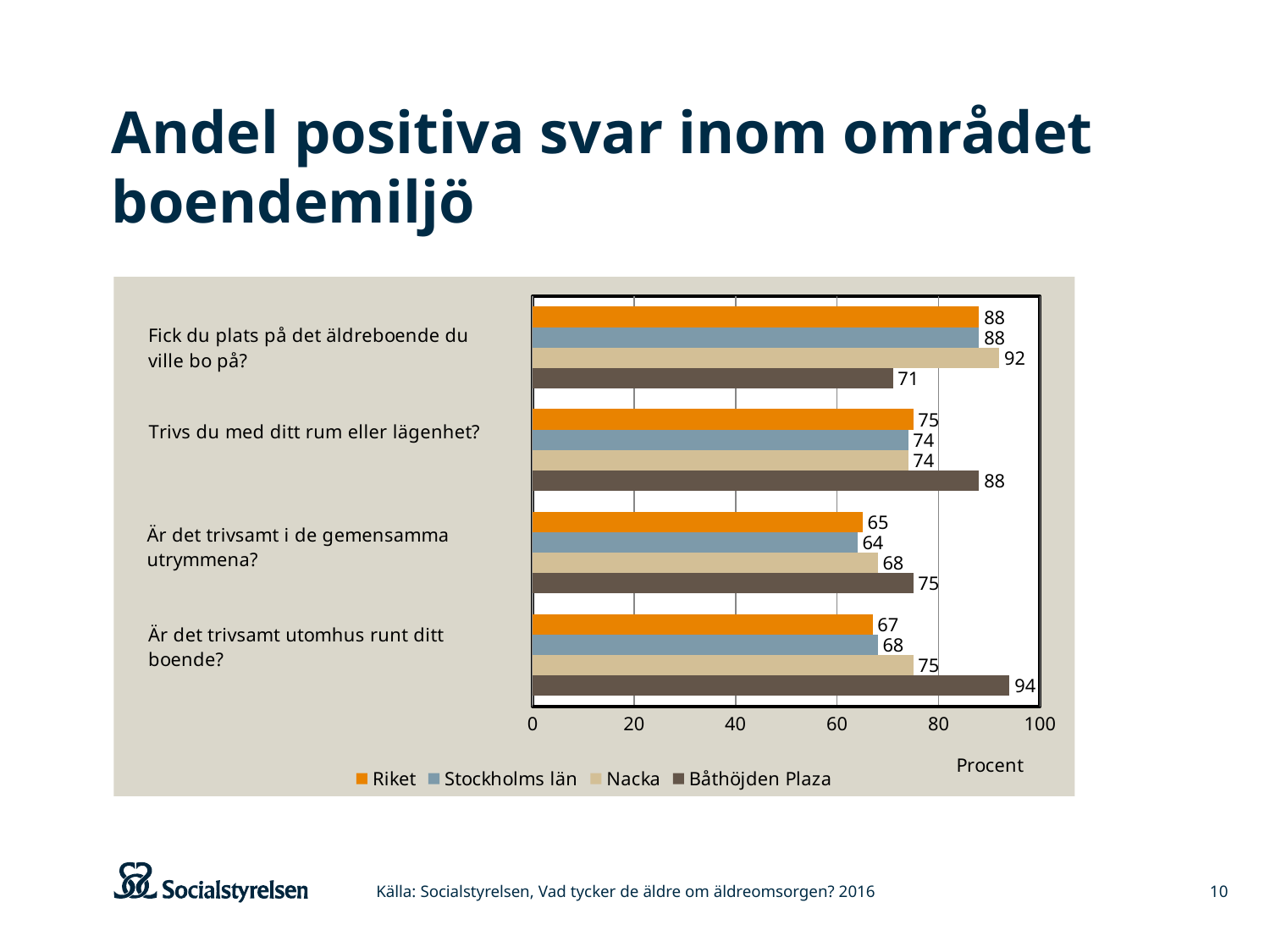
Which series has the highest value on "Är det trivsamt utomhus runt ditt boende?"? Båthöjden Plaza What is the value for Nacka on "Fick du plats på det äldreboende du ville bo på?"? 92 Which series has the lowest value on "Fick du plats på det äldreboende du ville bo på?"? Båthöjden Plaza What is the value for Riket on "Trivs du med ditt rum eller lägenhet?"? 75 What is the value for Båthöjden Plaza on "Är det trivsamt utomhus runt ditt boende?"? 94 How many series does the legend list? 4 What is the label on the horizontal axis of the chart? Procent What is the value for Stockholms län on "Är det trivsamt i de gemensamma utrymmena?"? 64 Which is larger on "Trivs du med ditt rum eller lägenhet?": Båthöjden Plaza or Nacka? Båthöjden Plaza What is the difference between Båthöjden Plaza and Riket on "Är det trivsamt utomhus runt ditt boende?"? 27 How many question categories are shown on the chart? 4 What kind of chart is shown on the slide? Bar chart